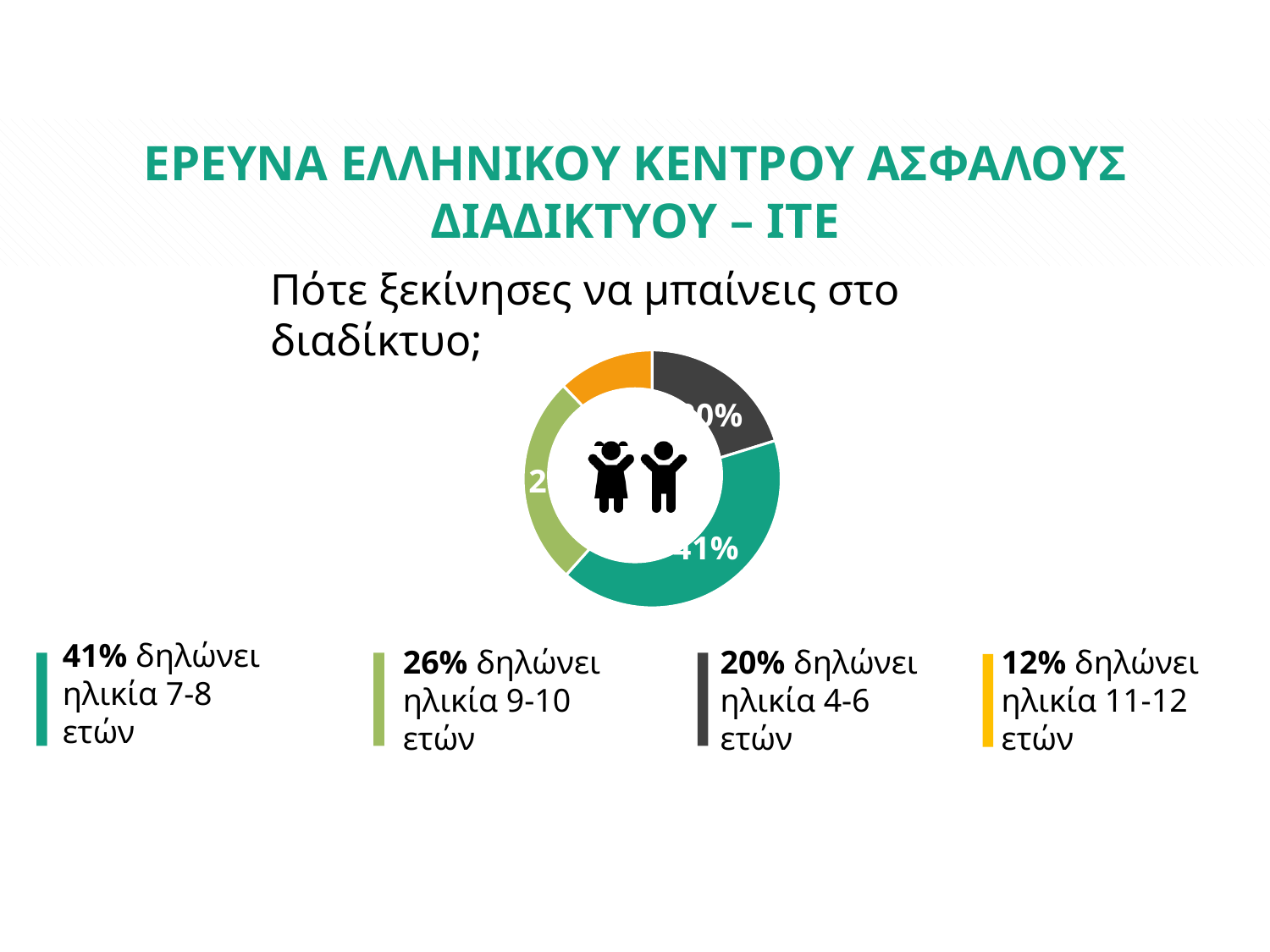
What colour is the slice representing the 7-8 years group? Teal (green) What percentage of respondents said they started using the internet at age 9-10? 26% What percentage of respondents said they started using the internet at age 11-12? 12% What percentage of respondents said they started using the internet at age 4-6? 20% What question does the chart answer, according to the text above it? Πότε ξεκίνησες να μπαίνεις στο διαδίκτυο; What kind of chart is shown on the slide? Pie chart (donut) Which is larger: the share for ages 4-6 or the share for ages 11-12? 4-6 years What percentage of respondents said they started using the internet at age 7-8? 41% Which age group has the smallest share of the pie? 11-12 years How many age groups (slices) does the chart show? 4 Which age group has the largest share of the pie? 7-8 years What is the difference in percentage points between the 7-8 years group and the 9-10 years group? 15